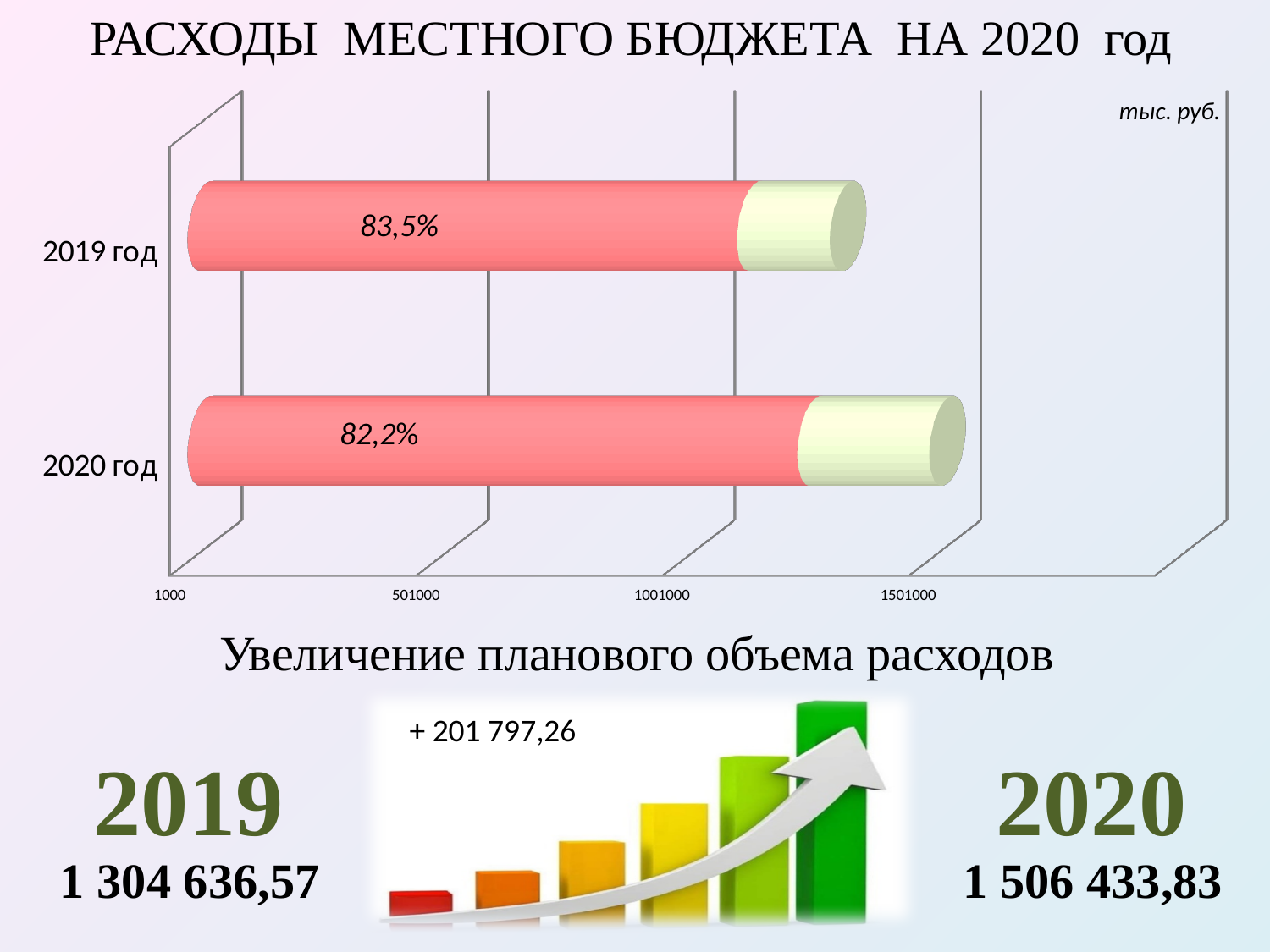
What is the difference between the percentages printed for 2019 год and 2020 год? 1,3% What unit is indicated in the top right corner of the chart? тыс. руб. What increase in planned expenditure is printed below the chart? + 201 797,26 What percentage is printed on the pink segment of the bar for 2019 год? 83,5% What is the title of the chart on the slide? РАСХОДЫ МЕСТНОГО БЮДЖЕТА НА 2020 год Is the total bar length for 2019 год greater or less than 1001000? greater Which year has the longer bar overall in the chart? 2020 год What percentage is printed on the pink segment of the bar for 2020 год? 82,2% How many categories (years) are plotted in the chart? 2 Do the bar lengths rise or fall from 2019 год to 2020 год? rise Which year has the larger percentage printed on its pink segment, 2019 год or 2020 год? 2019 год What kind of chart is shown on the slide? bar chart